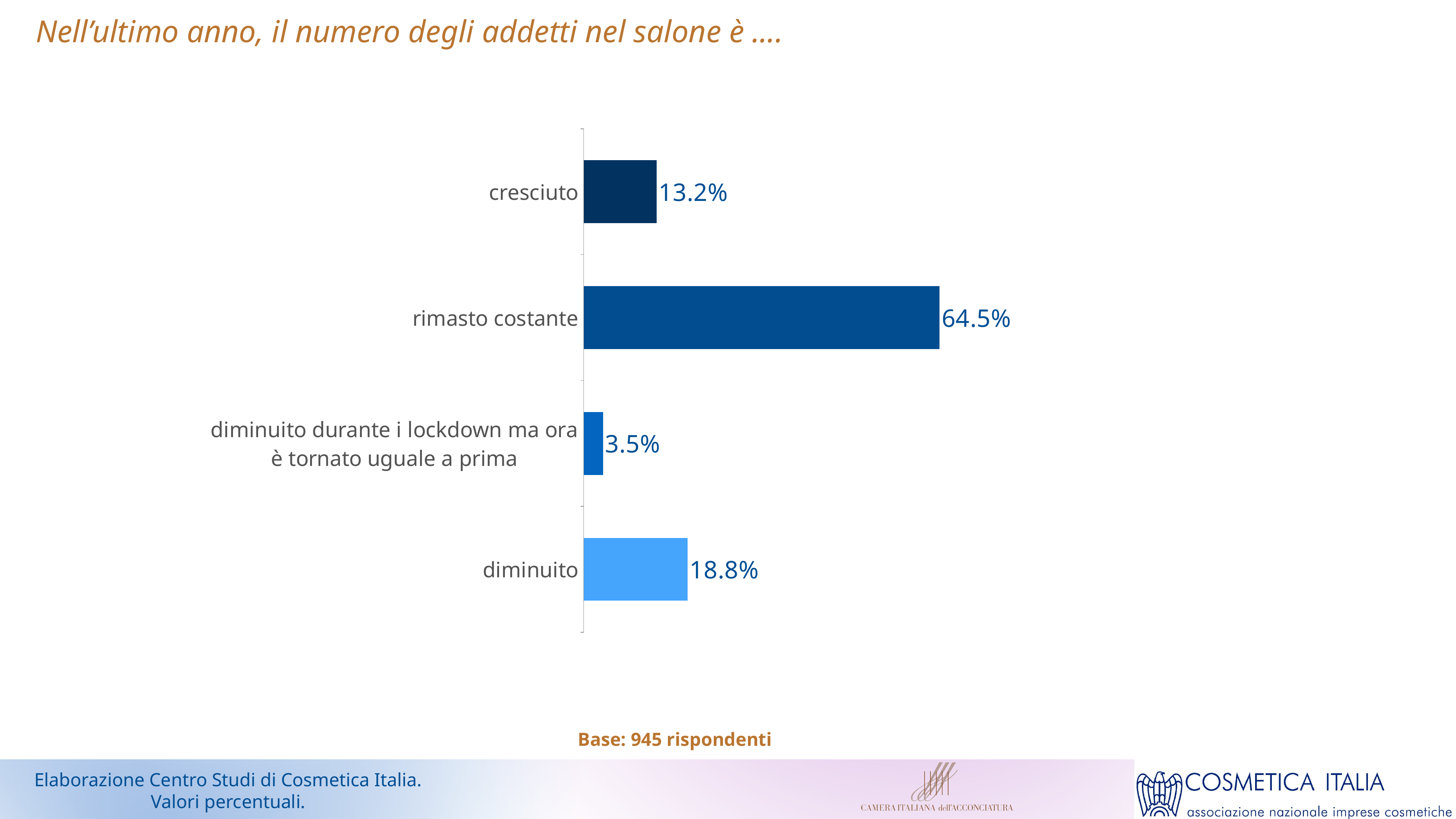
What is the value for "cresciuto"? 13.2% What is the value for "rimasto costante"? 64.5% Which category has the highest value? rimasto costante What kind of chart is shown on the slide? bar chart What is the difference between the values for "rimasto costante" and "diminuito"? 45.7% What is the value for "diminuito"? 18.8% What is the difference between the values for "diminuito" and "cresciuto"? 5.6% What is the value for "diminuito durante i lockdown ma ora è tornato uguale a prima"? 3.5% What is the base (number of respondents) stated below the chart? 945 rispondenti How many categories are shown in the chart? 4 Which category has the lowest value? diminuito durante i lockdown ma ora è tornato uguale a prima Which is larger, the value for "diminuito" or the value for "cresciuto"? diminuito